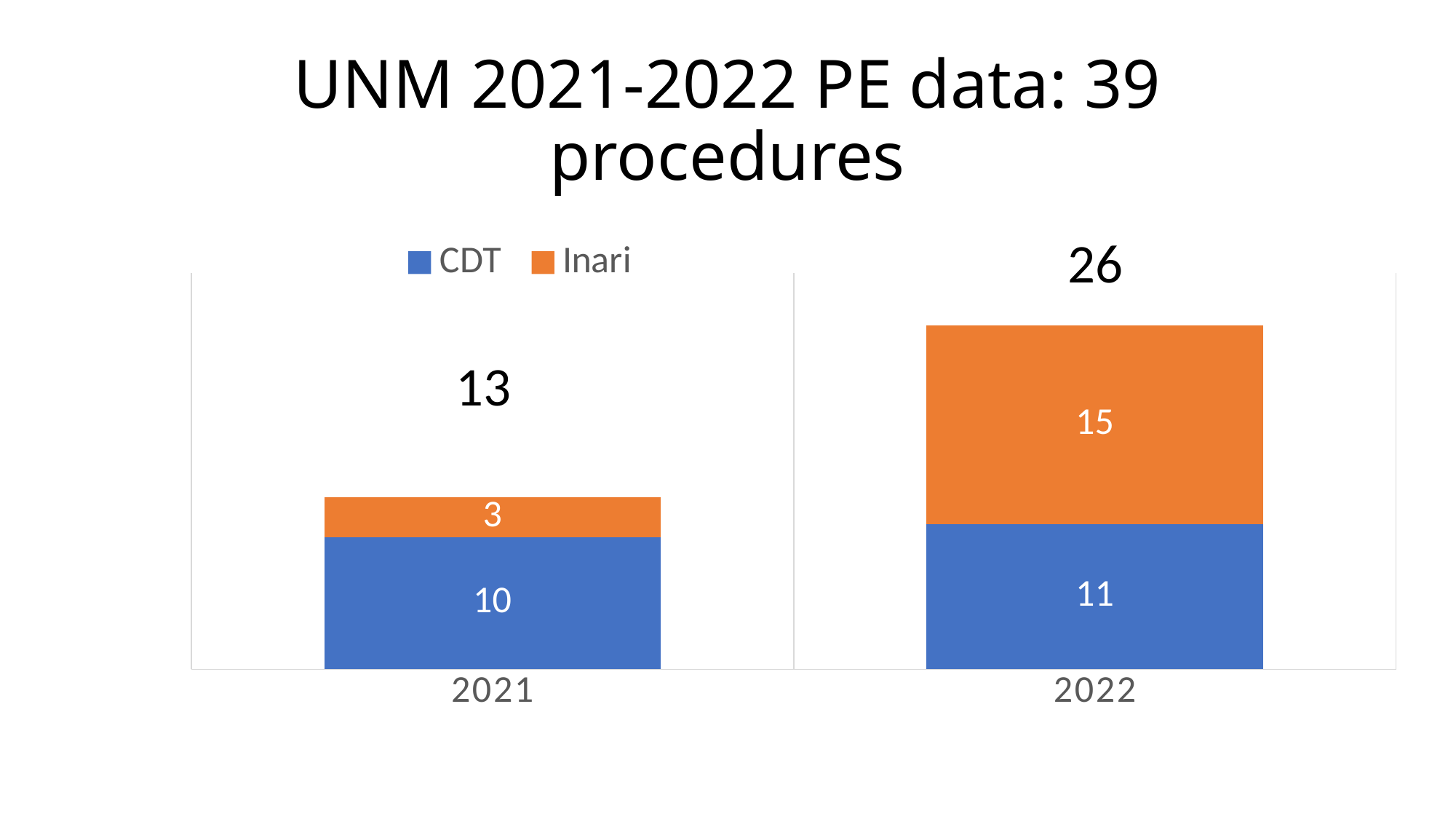
How many series does the legend list? 2 What is the CDT value for 2021? 10 What is the Inari value for 2022? 15 What is the total of the stacked bar for 2022? 26 Which year has the higher total number of procedures? 2022 What is the title of the slide? UNM 2021-2022 PE data: 39 procedures What is the difference between the Inari values for 2022 and 2021? 12 What is the Inari value for 2021? 3 What kind of chart is shown on the slide? Stacked bar chart What is the CDT value for 2022? 11 What is the total of the stacked bar for 2021? 13 Which is larger in 2022, the CDT value or the Inari value? Inari